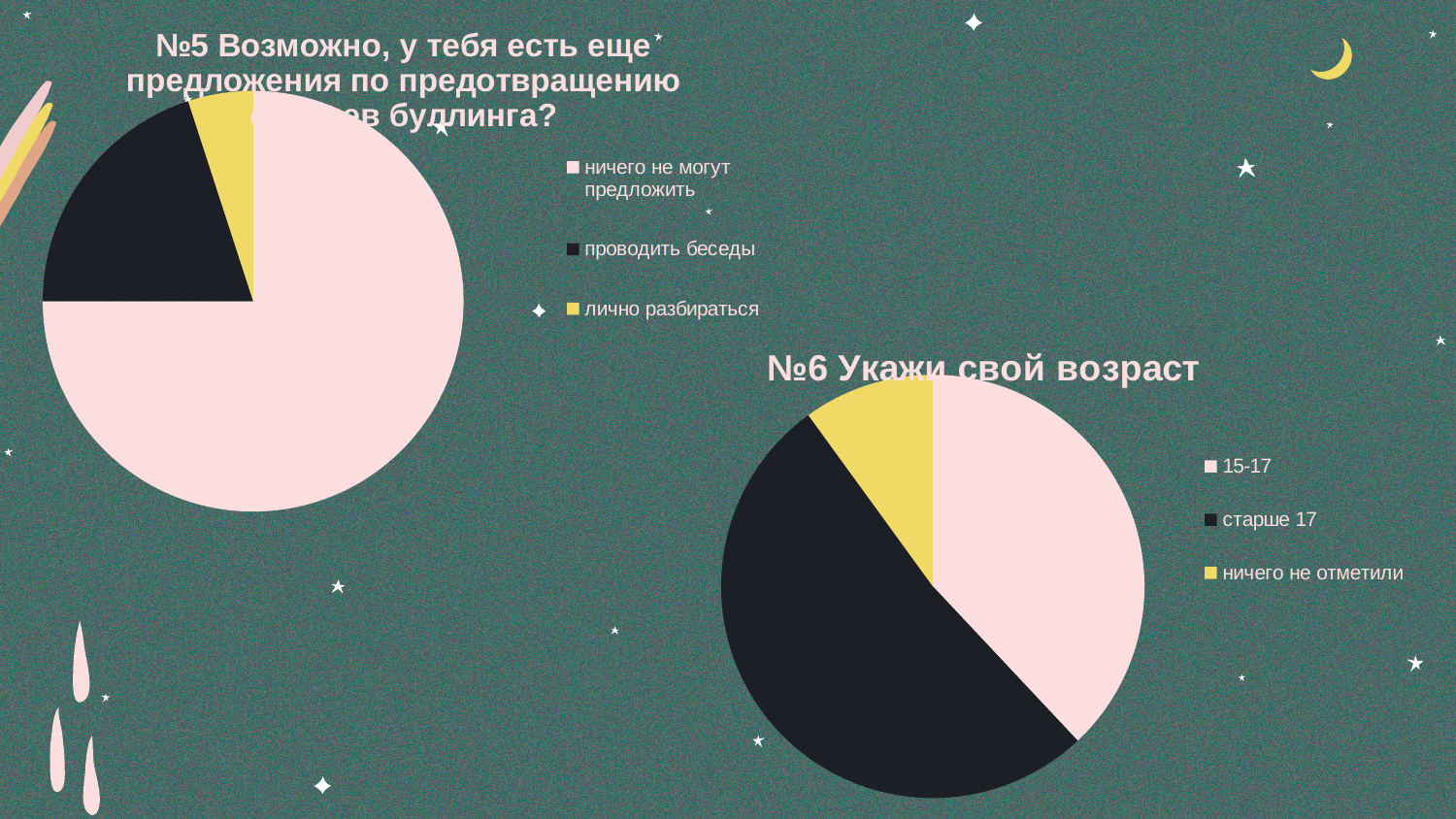
In the chart titled "№6 Укажи свой возраст", which category has the largest slice? старше 17 In the chart titled "№6 Укажи свой возраст", how many categories does the legend list? 3 In the chart titled "№6 Укажи свой возраст", what colour is the slice for "ничего не отметили"? yellow In the chart at the top left of the slide (question №5), what colour is the slice for "проводить беседы"? black What kind of chart is the chart at the top left of the slide (question №5)? pie chart In the chart at the top left of the slide (question №5), which category has the largest slice? ничего не могут предложить In the chart at the top left of the slide (question №5), which slice is larger: "проводить беседы" or "лично разбираться"? проводить беседы In the chart at the top left of the slide (question №5), how many slices does the pie have? 3 What kind of chart is the chart titled "№6 Укажи свой возраст"? pie chart In the chart at the top left of the slide (question №5), which category has the smallest slice? лично разбираться In the chart titled "№6 Укажи свой возраст", which slice is larger: "15-17" or "старше 17"? старше 17 In the chart titled "№6 Укажи свой возраст", which category has the smallest slice? ничего не отметили